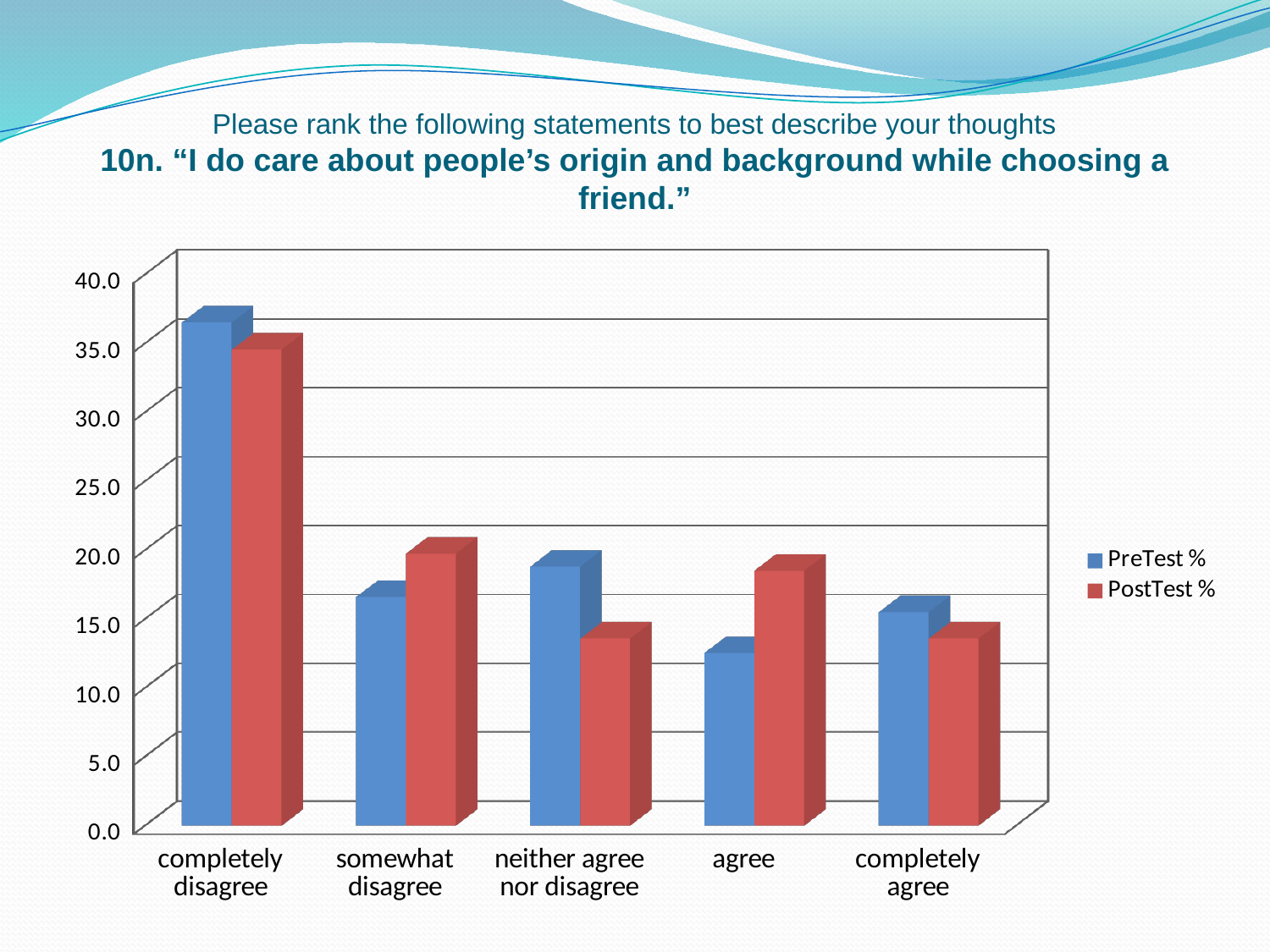
Which category has the highest PreTest % value? completely disagree For neither agree nor disagree, which is larger: the PreTest % or the PostTest % value? PreTest % Is the PostTest % value for neither agree nor disagree greater or less than 15.0? less Which category has the highest PostTest % value? completely disagree For somewhat disagree, which is larger: the PreTest % or the PostTest % value? PostTest % Which series is shown in red in the legend? PostTest % What kind of chart is shown on the slide? bar chart Which category has the lowest PreTest % value? agree How many series does the legend list? 2 How many response categories are shown on the x axis? 5 Is the PostTest % value for agree greater or less than 15.0? greater Is the PreTest % value for completely disagree greater or less than 35.0? greater